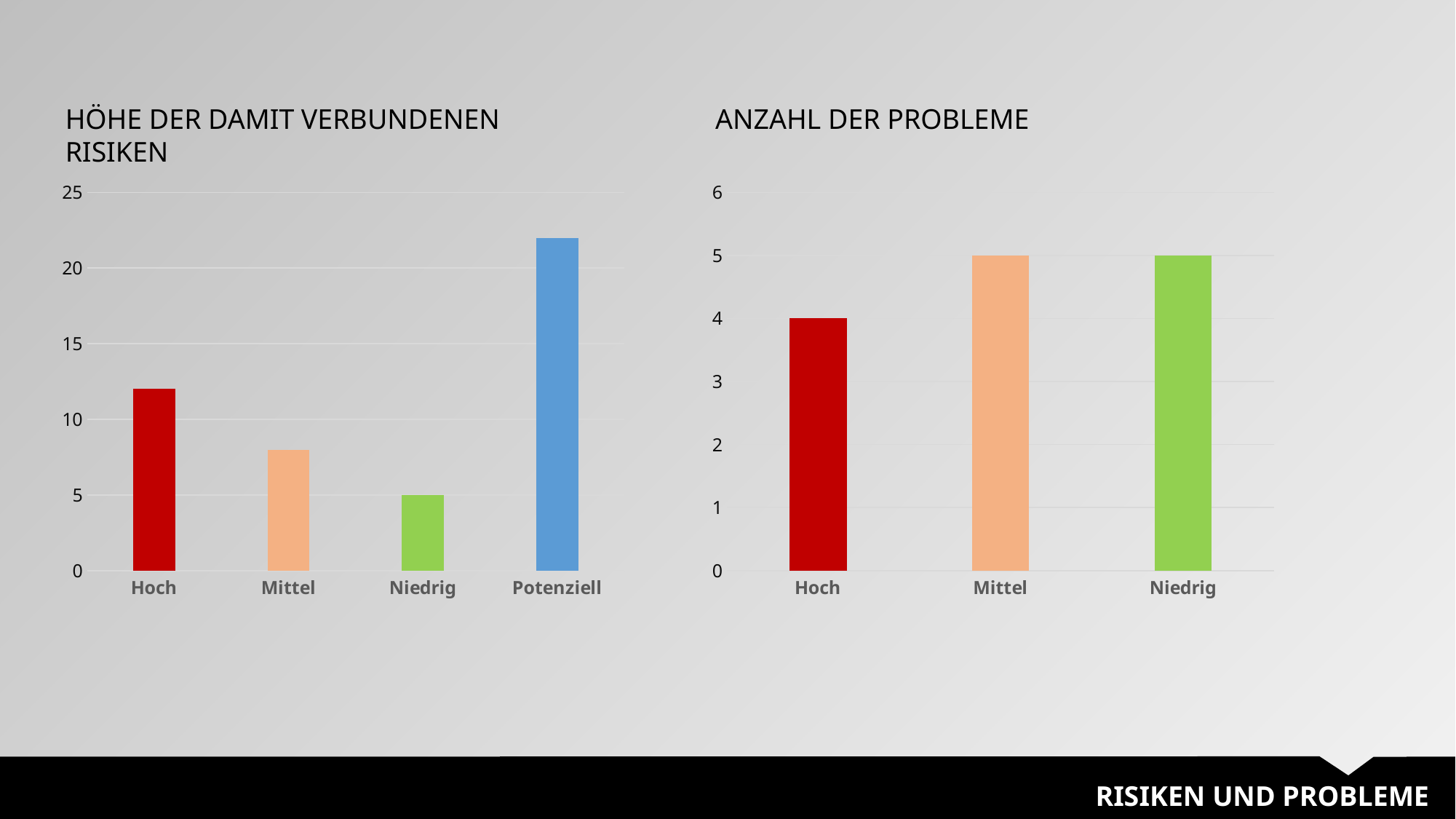
In the chart titled 'ANZAHL DER PROBLEME', what is the value for Hoch? 4 In the chart titled 'HÖHE DER DAMIT VERBUNDENEN RISIKEN', is the value for Mittel greater or less than 10? less In the chart titled 'HÖHE DER DAMIT VERBUNDENEN RISIKEN', which category has the lowest value? Niedrig In the chart titled 'HÖHE DER DAMIT VERBUNDENEN RISIKEN', is the value for Potenziell greater or less than 20? greater In the chart titled 'HÖHE DER DAMIT VERBUNDENEN RISIKEN', what is the value for Niedrig? 5 What kind of chart is the chart titled 'HÖHE DER DAMIT VERBUNDENEN RISIKEN'? bar chart In the chart titled 'ANZAHL DER PROBLEME', how many categories are shown on the x axis? 3 In the chart titled 'HÖHE DER DAMIT VERBUNDENEN RISIKEN', which is larger, the value for Hoch or the value for Mittel? Hoch In the chart titled 'ANZAHL DER PROBLEME', what is the value for Mittel? 5 In the chart titled 'HÖHE DER DAMIT VERBUNDENEN RISIKEN', which category has the highest value? Potenziell In the chart titled 'ANZAHL DER PROBLEME', which category has the lowest value? Hoch In the chart titled 'ANZAHL DER PROBLEME', what is the difference between the values for Mittel and Hoch? 1